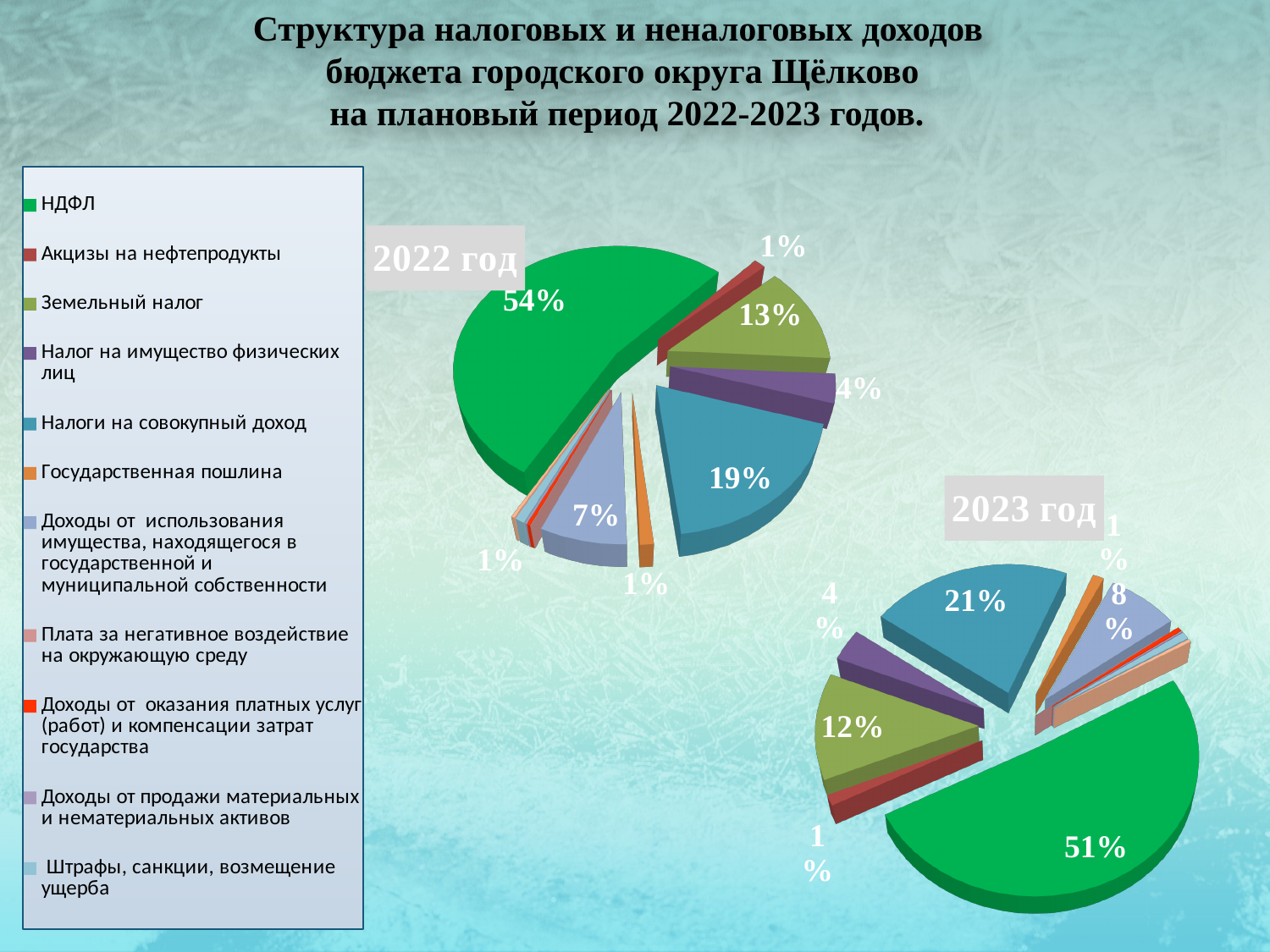
In the 2022 год chart, which category has the largest share? НДФЛ What is the difference between the НДФЛ share in the 2022 год chart and in the 2023 год chart? 3% In the 2023 год chart, what share does Налоги на совокупный доход have? 21% In the 2022 год chart, what share does Земельный налог have? 13% In the 2023 год chart, what share does НДФЛ have? 51% In the 2022 год chart, what share does Налоги на совокупный доход have? 19% How many categories does the legend list? 11 In the 2022 год chart, what share does Налог на имущество физических лиц have? 4% In the 2023 год chart, what share does Земельный налог have? 12% What type of charts are shown on the slide? Pie charts In the 2022 год chart, what share does НДФЛ have? 54% Which is larger: the Налоги на совокупный доход share in the 2022 год chart or in the 2023 год chart? 2023 год